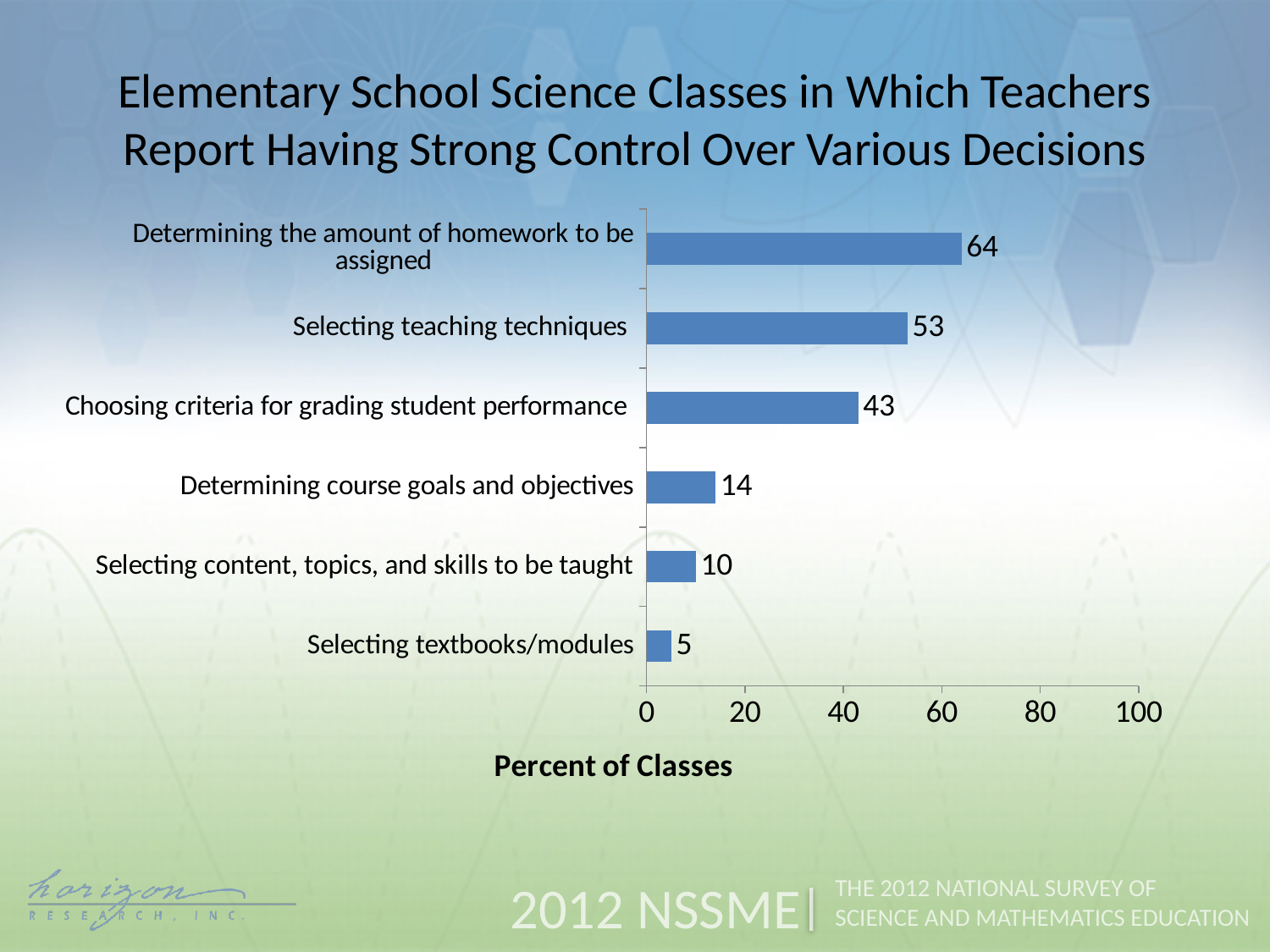
What is the difference between the values for "Selecting teaching techniques" and "Selecting textbooks/modules"? 48 What is the value for "Selecting textbooks/modules"? 5 How many categories are shown in the chart? 6 Is the value for "Selecting teaching techniques" greater or less than 40? greater What kind of chart is shown on the slide? Bar chart Which category has the highest value? Determining the amount of homework to be assigned Which is larger: the value for "Selecting content, topics, and skills to be taught" or the value for "Determining course goals and objectives"? Determining course goals and objectives Which category has the lowest value? Selecting textbooks/modules What is the value for "Selecting teaching techniques"? 53 What is the label of the horizontal axis? Percent of Classes What is the difference between the values for "Determining the amount of homework to be assigned" and "Choosing criteria for grading student performance"? 21 What is the value for "Determining course goals and objectives"? 14